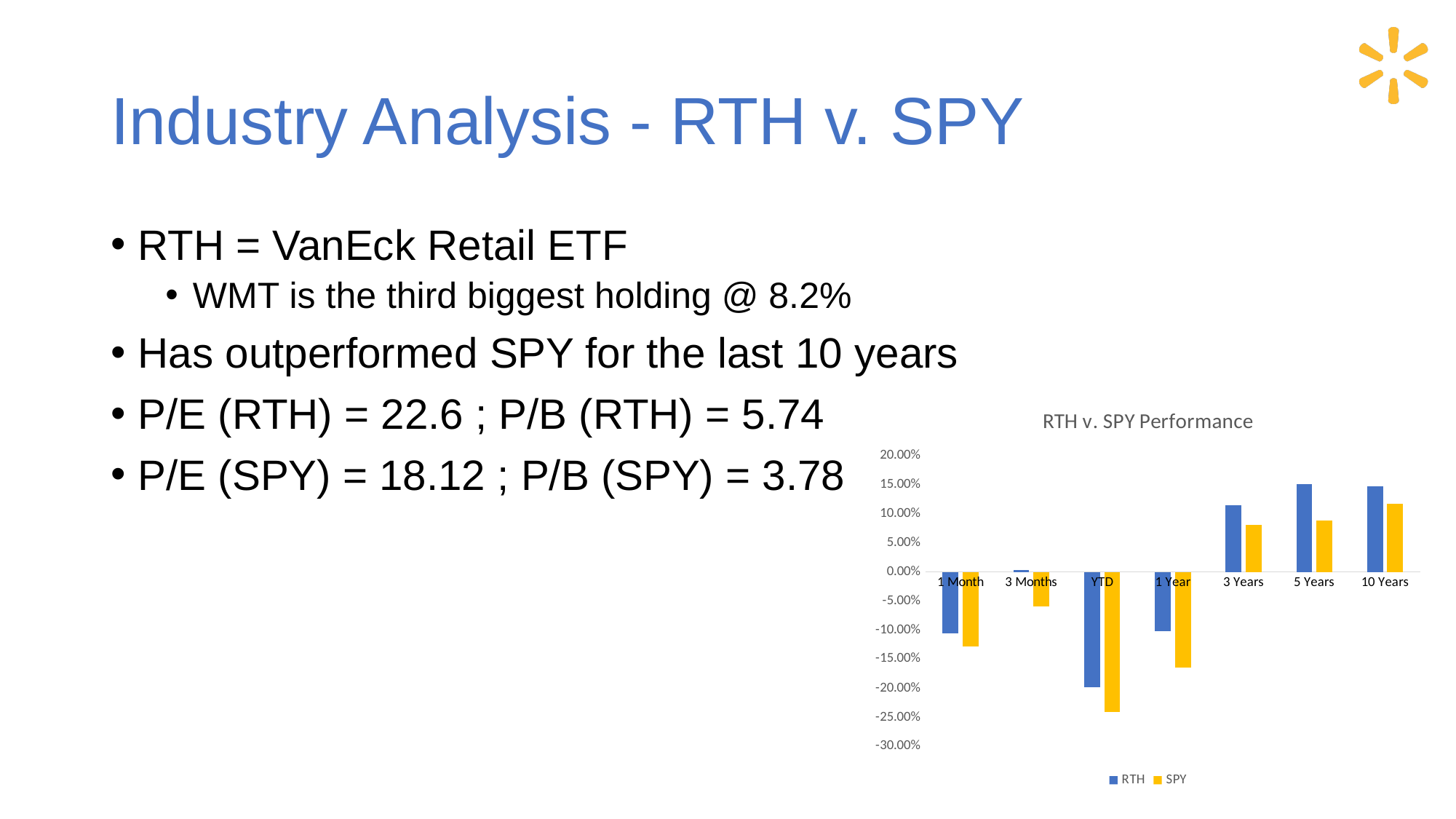
What is the title of the chart on the slide? RTH v. SPY Performance In the 'RTH v. SPY Performance' chart, is the SPY value for 1 Year greater or less than -15.00%? less In the 'RTH v. SPY Performance' chart, which period has the lowest SPY value? YTD In the 'RTH v. SPY Performance' chart, is the SPY value for YTD greater or less than -20.00%? less In the 'RTH v. SPY Performance' chart, for 3 Years, which is higher: RTH or SPY? RTH In the 'RTH v. SPY Performance' chart, is the RTH value for 1 Month greater or less than -5.00%? less What kind of chart is the 'RTH v. SPY Performance' chart? bar chart Which colour represents SPY in the 'RTH v. SPY Performance' chart? yellow In the 'RTH v. SPY Performance' chart, which period has the highest SPY value? 10 Years How many series does the legend of the 'RTH v. SPY Performance' chart list? 2 How many time-period categories are shown on the x axis of the 'RTH v. SPY Performance' chart? 7